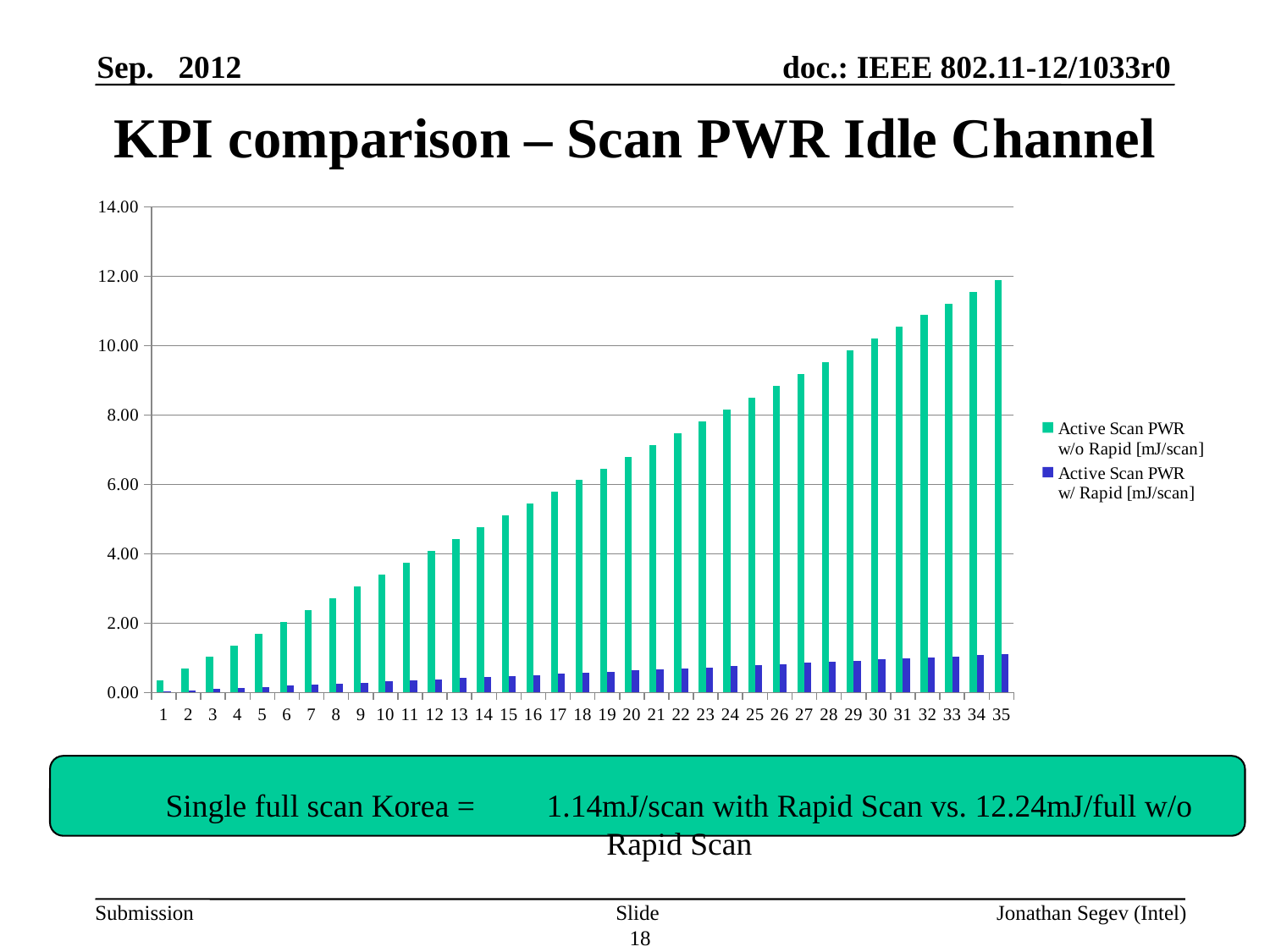
Which category has the highest value for Active Scan PWR w/o Rapid [mJ/scan]? 35 Is the value for Active Scan PWR w/o Rapid [mJ/scan] at category 10 greater or less than 4.00? less Which category has the lowest value for Active Scan PWR w/o Rapid [mJ/scan]? 1 Is the value for Active Scan PWR w/ Rapid [mJ/scan] at category 35 greater or less than 2.00? less What kind of chart is shown on the slide? bar chart Do the values for Active Scan PWR w/o Rapid [mJ/scan] rise or fall as the category number increases along the x axis? rise Is the value for Active Scan PWR w/o Rapid [mJ/scan] at category 35 greater or less than 10.00? greater At category 30, which series has the larger value: Active Scan PWR w/o Rapid [mJ/scan] or Active Scan PWR w/ Rapid [mJ/scan]? Active Scan PWR w/o Rapid [mJ/scan] What is the title of the slide containing the chart? KPI comparison – Scan PWR Idle Channel How many series does the chart legend list? 2 How many categories are shown along the x axis of the chart? 35